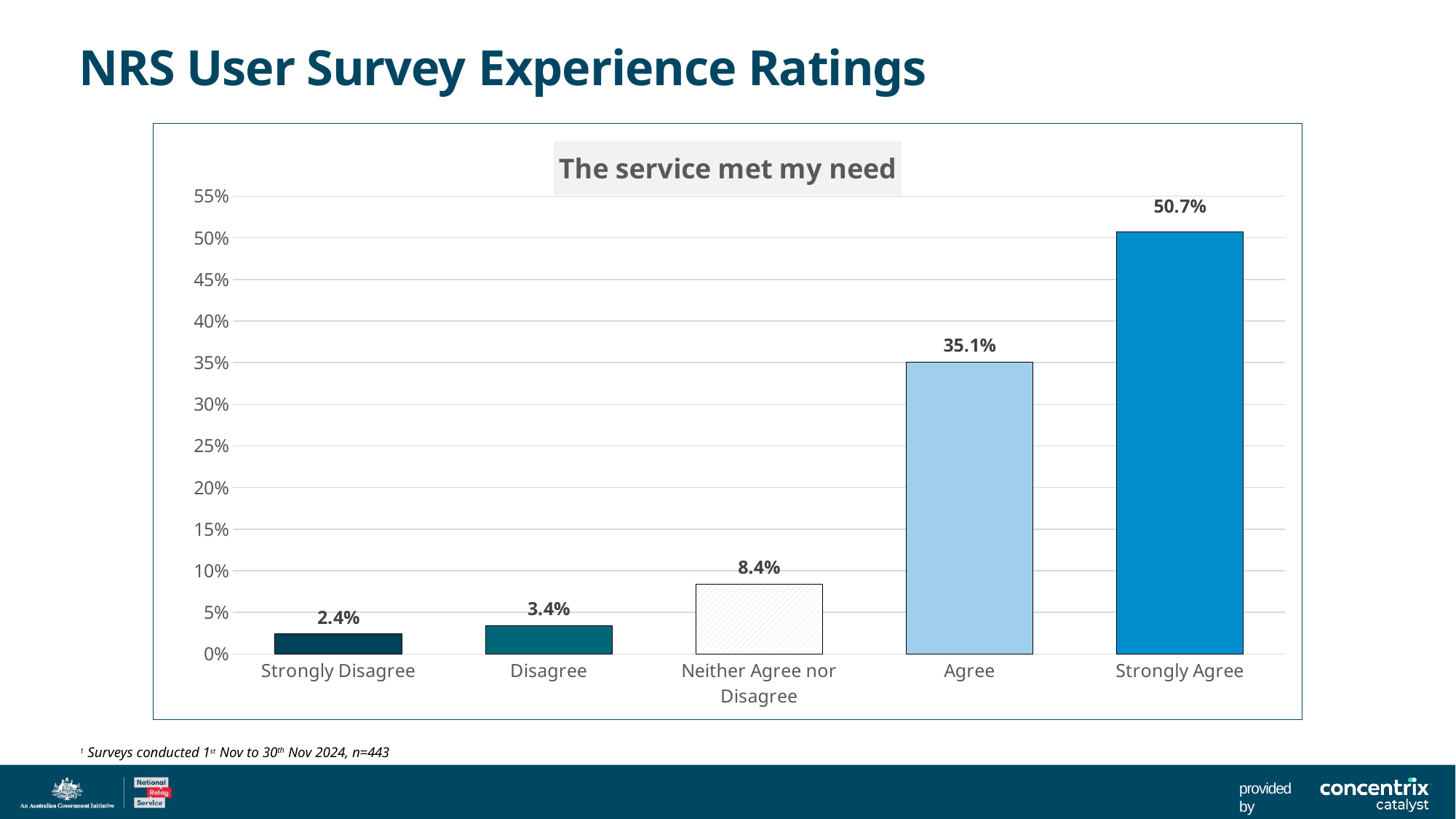
What is the difference between the Disagree and Strongly Disagree values? 1.0% What percentage of respondents answered Strongly Agree to 'The service met my need'? 50.7% How many response categories are shown on the x axis? 5 What kind of chart is shown on the slide? Bar chart What is the value shown for Neither Agree nor Disagree? 8.4% Which response category has the highest value? Strongly Agree Which is larger, the value for Disagree or the value for Neither Agree nor Disagree? Neither Agree nor Disagree Do the values rise or fall moving from Strongly Disagree to Strongly Agree along the x axis? Rise What is the difference between the Strongly Agree and Agree values? 15.6% Which response category has the lowest value? Strongly Disagree What is the value shown for Strongly Disagree? 2.4% What is the value shown for Agree? 35.1%